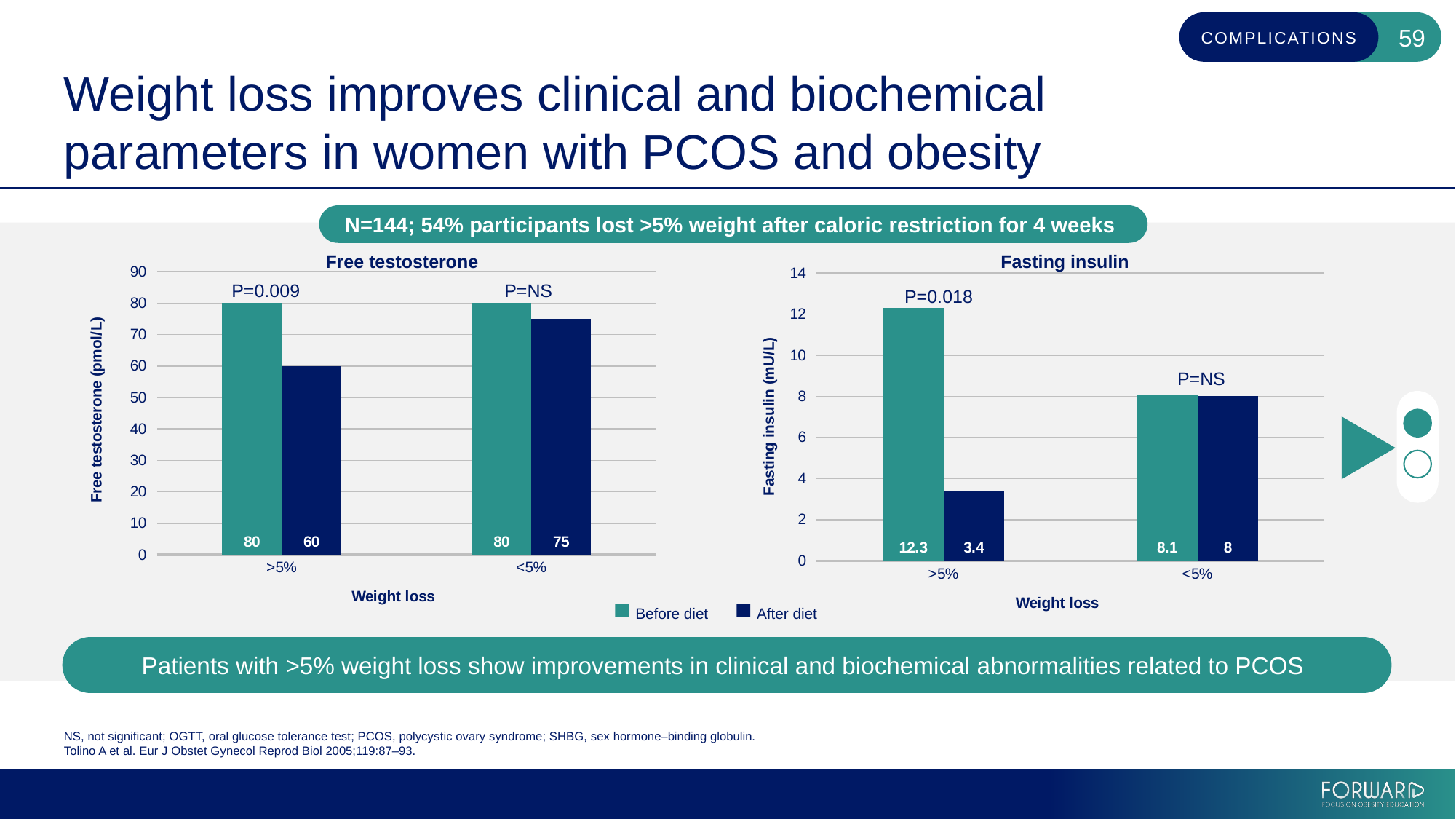
How many series does the legend list? 2 In the Fasting insulin chart, what is the Before diet value for the <5% weight loss group? 8.1 In the Fasting insulin chart, what is the After diet value for the >5% weight loss group? 3.4 In the Free testosterone chart, what is the difference between the Before diet and After diet values for the >5% group? 20 In the Free testosterone chart, what is the After diet value for the >5% weight loss group? 60 What kind of chart is the Free testosterone chart? Bar chart In the Fasting insulin chart, what is the difference between the Before diet and After diet values for the >5% group? 8.9 In the Fasting insulin chart, which bar is the lowest? After diet, >5% In the Free testosterone chart, which is larger for the <5% group: Before diet or After diet? Before diet In the Free testosterone chart, what is the Before diet value for the >5% weight loss group? 80 How many weight loss categories are shown on the x axis of the Fasting insulin chart? 2 What is the y-axis label of the Fasting insulin chart? Fasting insulin (mU/L)